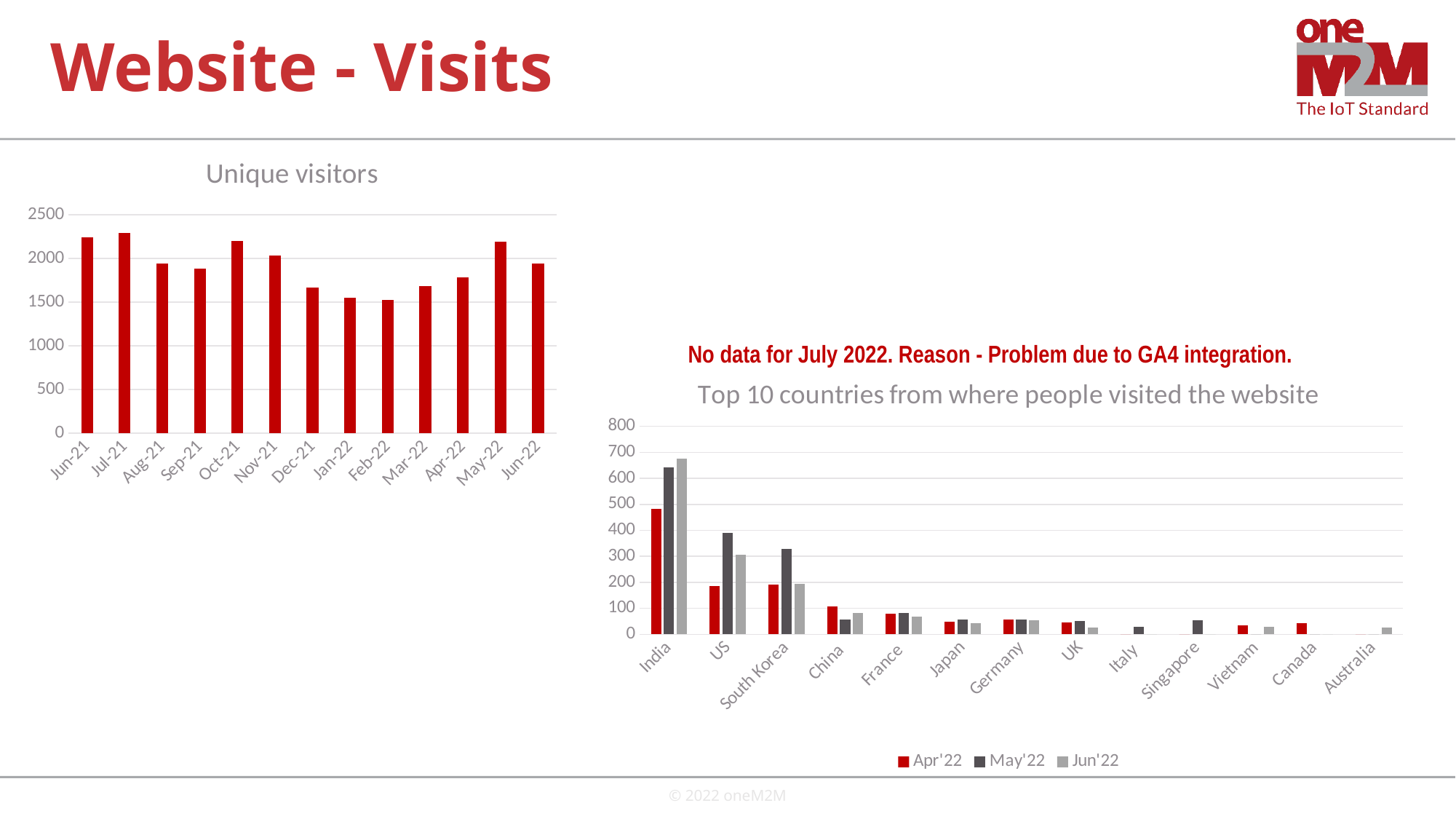
On the Top 10 countries chart, which country has the highest value for Jun'22? India On the Unique visitors chart, which is larger, the value for Oct-21 or the value for Dec-21? Oct-21 On the Unique visitors chart, do the values rise or fall from Jul-21 to Feb-22? fall On the Unique visitors chart, is the value for Dec-21 greater or less than 2000? less On the Unique visitors chart, how many months are shown on the x axis? 13 On the Top 10 countries chart, is the Jun'22 value for India greater or less than 600? greater On the Top 10 countries chart, is the Apr'22 value for US greater or less than 200? less On the Top 10 countries chart, how many series does the legend list? 3 On the Top 10 countries chart, what are the legend entries? Apr'22, May'22, Jun'22 On the Top 10 countries chart, which is larger, the May'22 value for US or the May'22 value for South Korea? US What kind of chart is the Unique visitors chart? bar chart